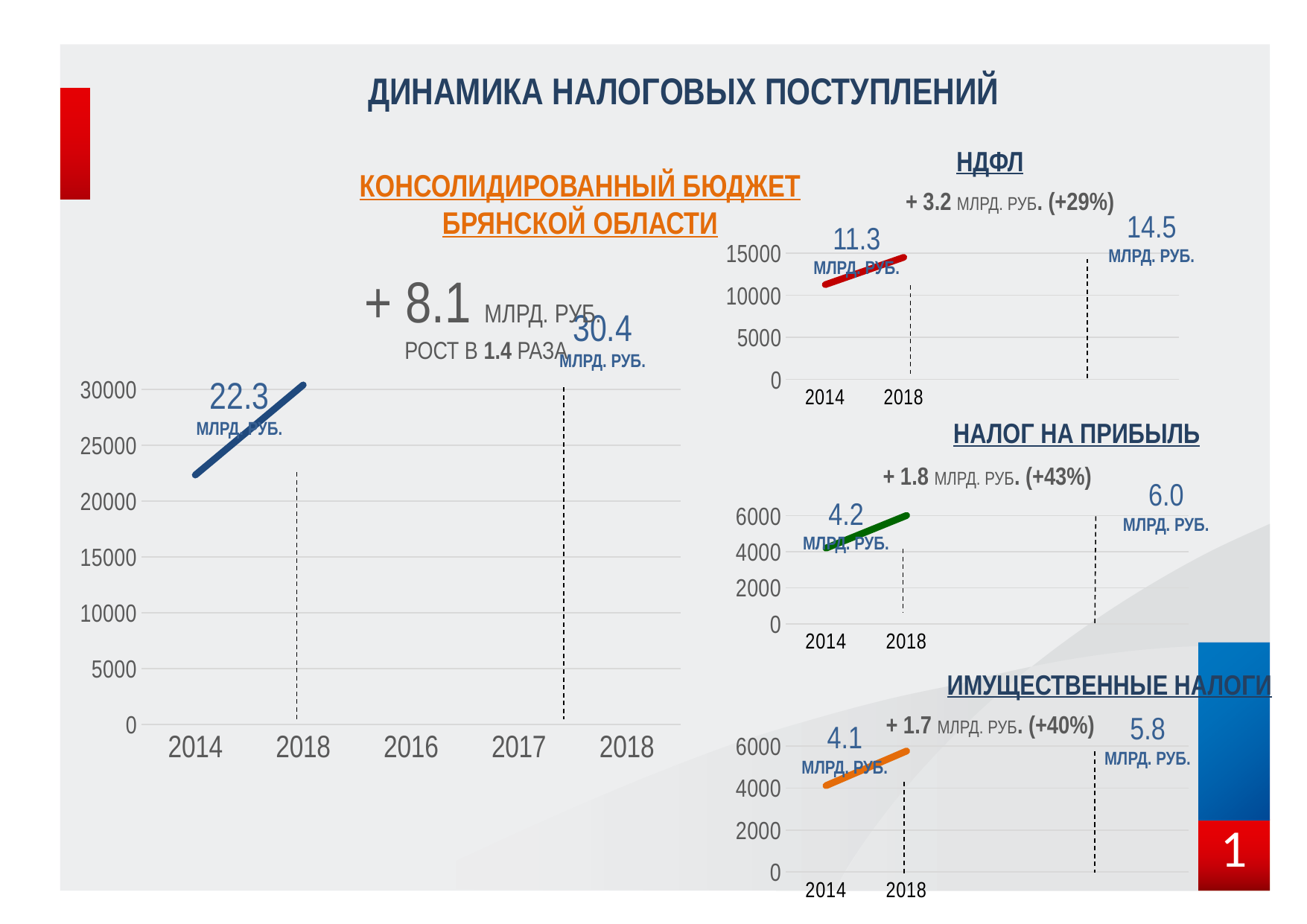
On the 'НАЛОГ НА ПРИБЫЛЬ' chart, does the value rise or fall from 2014 to 2018? rise On the 'КОНСОЛИДИРОВАННЫЙ БЮДЖЕТ БРЯНСКОЙ ОБЛАСТИ' chart, what value is labelled for 2018? 30.4 млрд. руб. On the 'ИМУЩЕСТВЕННЫЕ НАЛОГИ' chart, what value is labelled for 2014? 4.1 млрд. руб. What kind of chart is the 'НДФЛ' chart? line chart On the 'КОНСОЛИДИРОВАННЫЙ БЮДЖЕТ БРЯНСКОЙ ОБЛАСТИ' chart, what value is labelled for 2014? 22.3 млрд. руб. On the 'КОНСОЛИДИРОВАННЫЙ БЮДЖЕТ БРЯНСКОЙ ОБЛАСТИ' chart, by how much did the value grow from 2014 to 2018? 8.1 млрд. руб. On the 'НДФЛ' chart, what value is labelled for 2018? 14.5 млрд. руб. On the 'ИМУЩЕСТВЕННЫЕ НАЛОГИ' chart, which year has the higher value, 2014 or 2018? 2018 On the 'НДФЛ' chart, what percentage growth is shown between 2014 and 2018? +29% On the 'НАЛОГ НА ПРИБЫЛЬ' chart, what value is labelled for 2018? 6.0 млрд. руб. On the 'НДФЛ' chart, what value is labelled for 2014? 11.3 млрд. руб. On the 'НАЛОГ НА ПРИБЫЛЬ' chart, what is the difference between the 2018 and 2014 values? 1.8 млрд. руб.